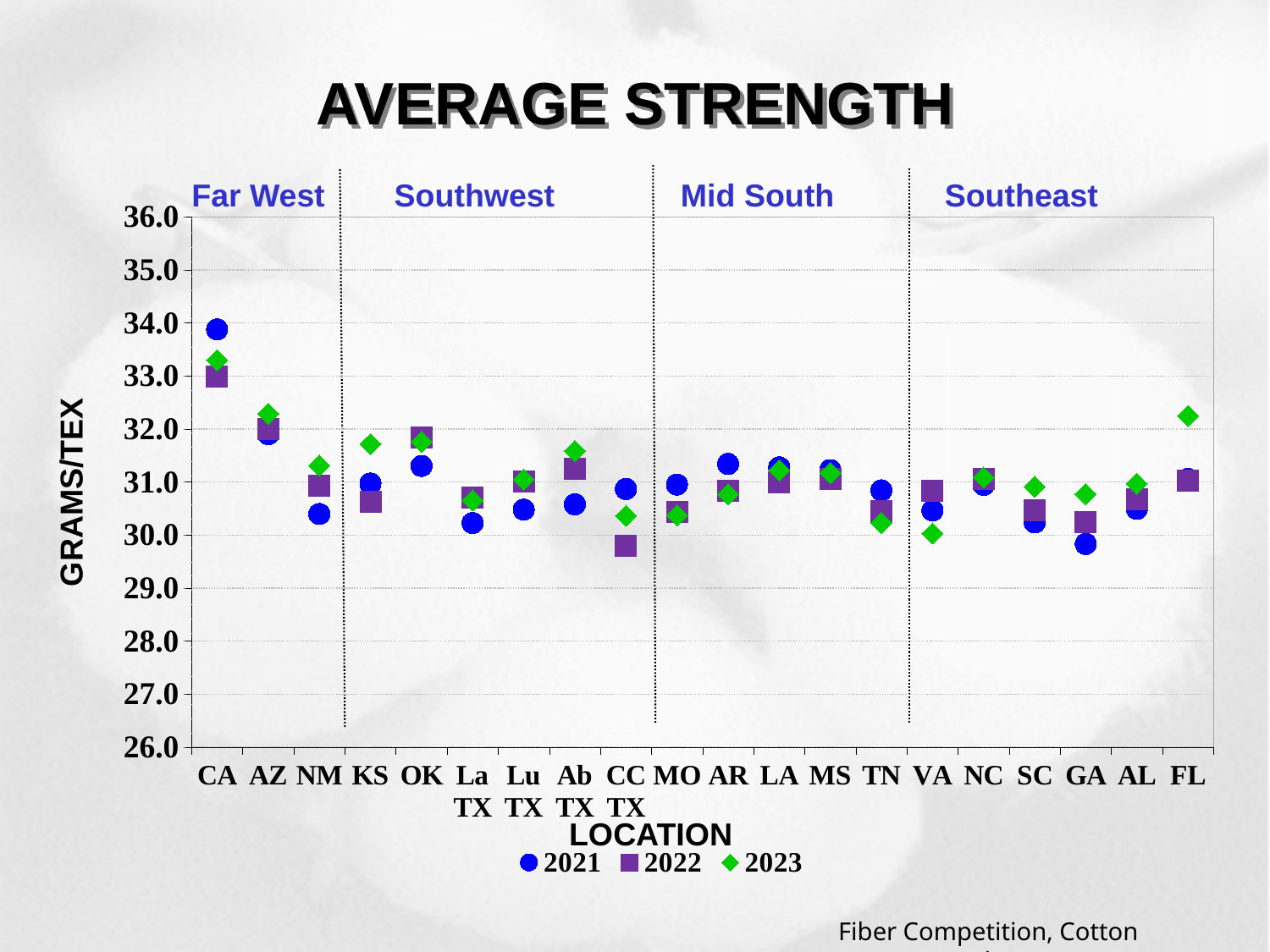
Do the 2021 values rise or fall across the Far West locations from CA to NM? fall Is the 2021 value for CA greater or less than 33.0? greater Which is larger at KS, the 2021 value or the 2023 value? 2023 What is the label on the y axis? GRAMS/TEX Which location has the lowest 2022 value? CC TX What kind of chart is shown on the slide? Scatter (dot) chart Which location has the highest 2023 value? CA Which location has the highest 2021 value? CA Is the 2023 value for KS greater or less than 31.0? greater How many series does the legend list? 3 Is the 2021 value for NM greater or less than 31.0? less How many locations are plotted along the x axis? 20